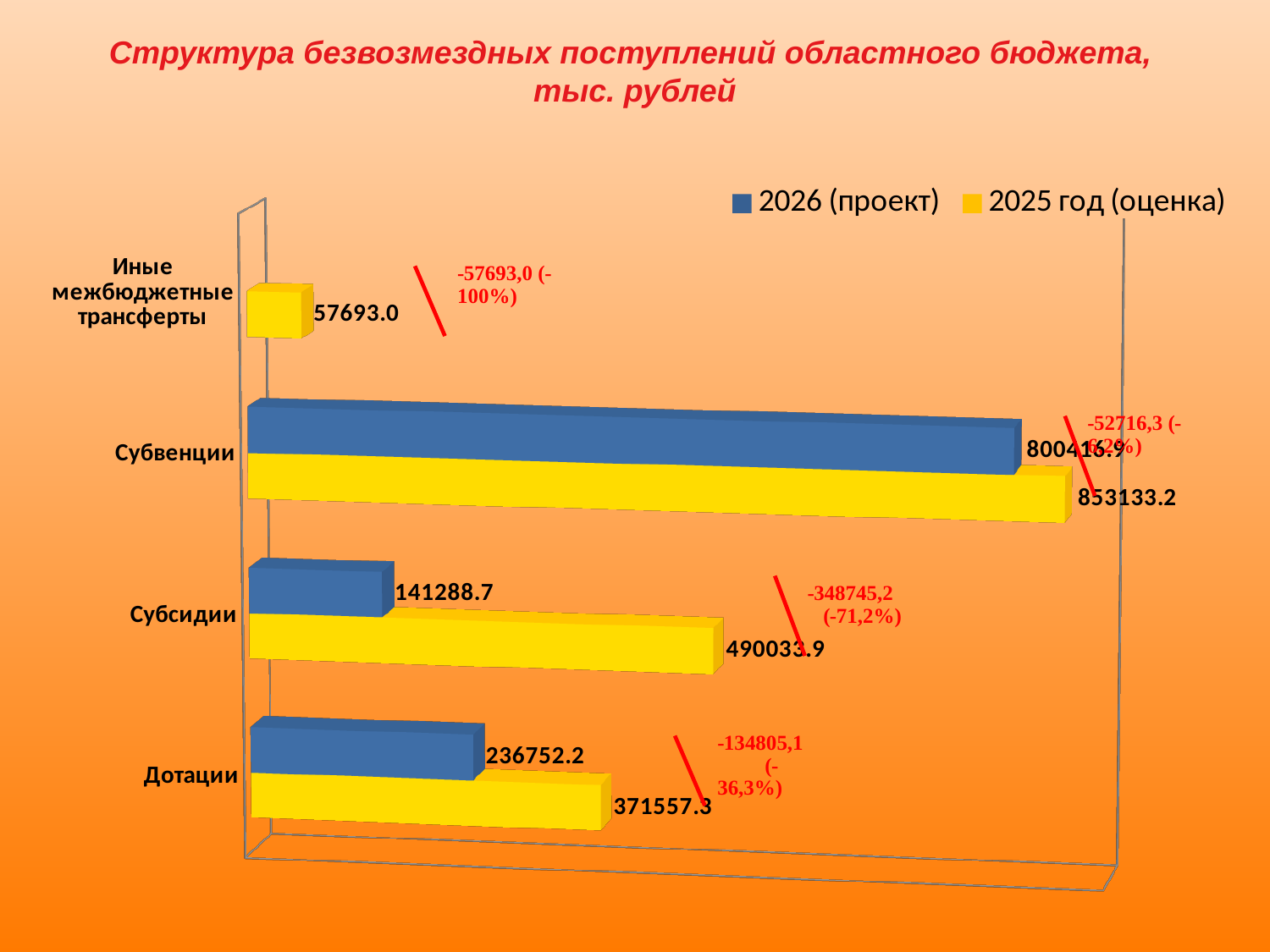
What is the value for Субвенции in the 2025 год (оценка) series? 853133.2 What kind of chart is shown on the slide? bar chart What is the value for Иные межбюджетные трансферты in the 2025 год (оценка) series? 57693.0 Which is larger in the 2026 (проект) series: Дотации or Субсидии? Дотации How many categories are shown on the chart? 4 Which category has the lowest value in the 2025 год (оценка) series? Иные межбюджетные трансферты What is the value for Субсидии in the 2026 (проект) series? 141288.7 How many series does the legend list? 2 What is the difference between the 2025 год (оценка) and 2026 (проект) values for Субсидии? 348745.2 What is the value for Дотации in the 2025 год (оценка) series? 371557.3 Which category has the highest value in the 2025 год (оценка) series? Субвенции What colour represents the 2026 (проект) series in the legend? blue